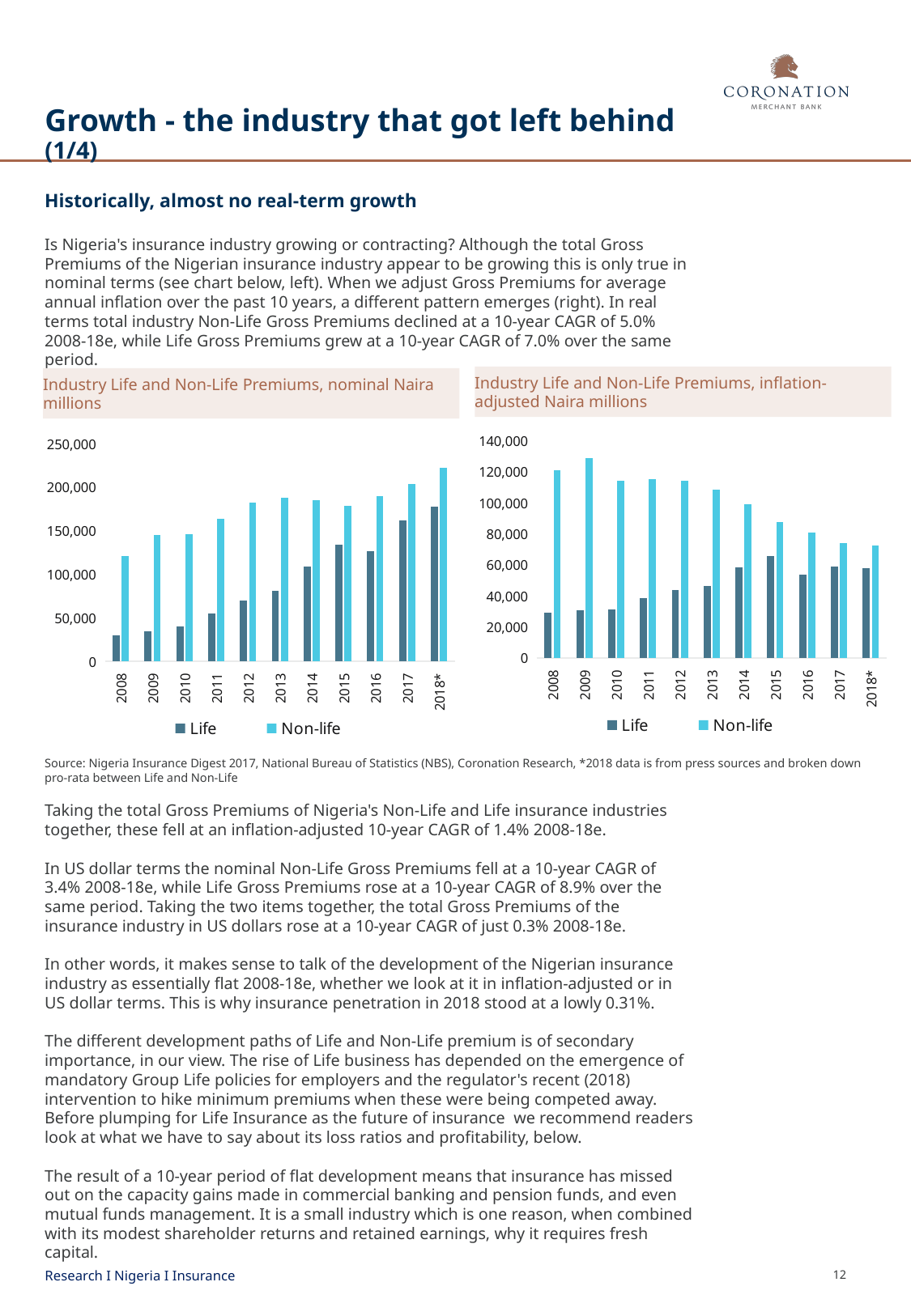
In the left chart (nominal Naira millions), which year has the highest Non-life value? 2018* How many years are shown on the x axis of the right chart, 'Industry Life and Non-Life Premiums, inflation-adjusted Naira millions'? 11 How many series does the legend of the left chart list? 2 In the right chart (inflation-adjusted Naira millions), which year has the highest Life value? 2015 In the left chart (nominal Naira millions), which year has the lowest Life value? 2008 In the left chart (nominal Naira millions), do the Life values generally rise or fall from 2008 to 2018*? rise In the right chart (inflation-adjusted Naira millions), which is larger in 2016, Life or Non-life? Non-life What kind of chart is the left chart, 'Industry Life and Non-Life Premiums, nominal Naira millions'? Bar chart What are the two legend entries of the right chart? Life and Non-life In the right chart (inflation-adjusted Naira millions), is the Non-life value for 2018* greater or less than 80,000? less In the right chart (inflation-adjusted Naira millions), which year has the highest Non-life value? 2009 In the left chart (nominal Naira millions), is the Life value for 2018* greater or less than 150,000? greater